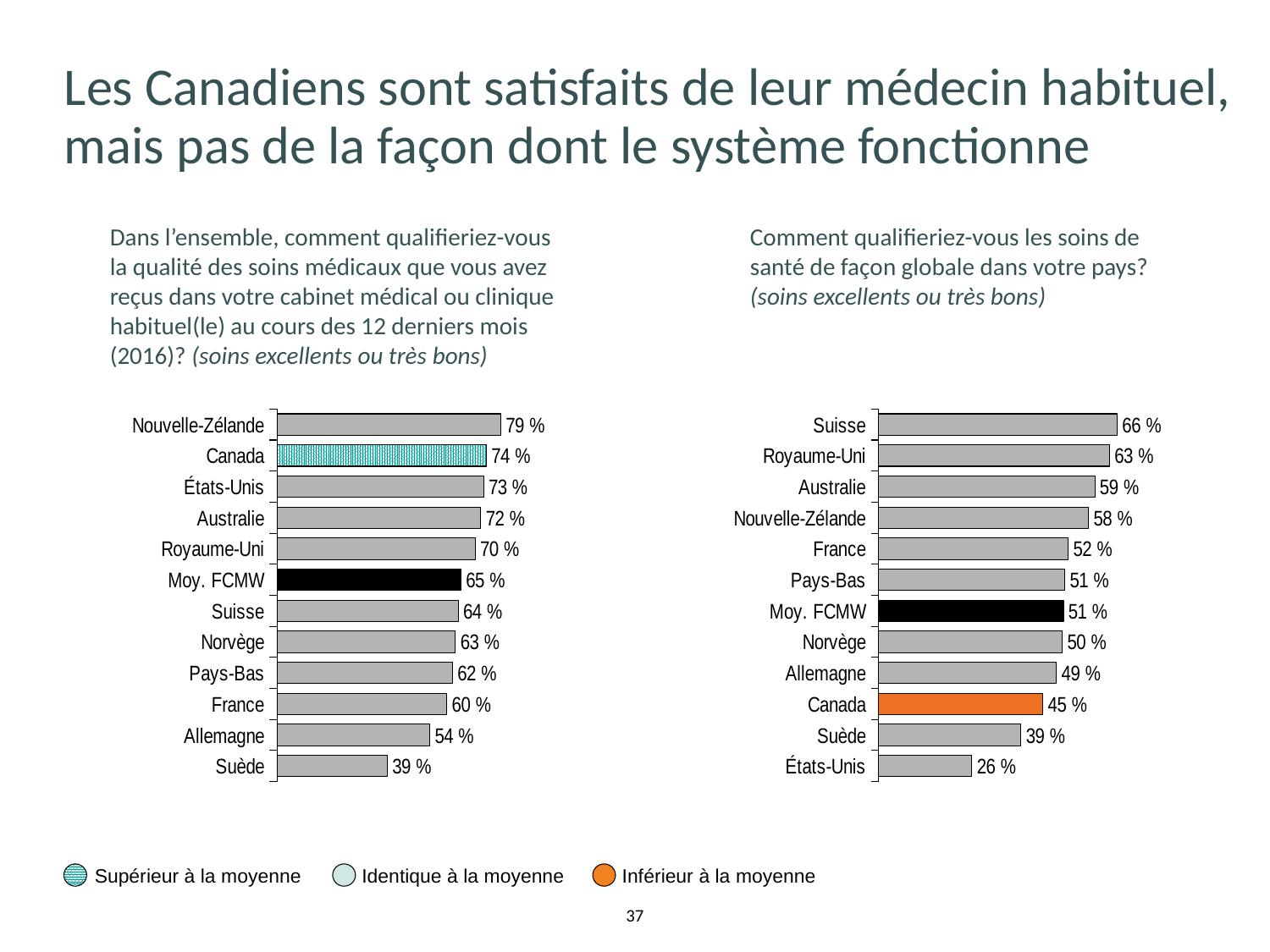
What type of chart is the right chart? Bar chart In the left chart, which country has the highest value? Nouvelle-Zélande In the right chart, which is larger, the value for Royaume-Uni or the value for France? Royaume-Uni In the right chart, which country has the lowest value? États-Unis In the left chart, what is the difference between Nouvelle-Zélande and Suède? 40 % In the left chart, how many bars are shown? 12 In the right chart, what is the difference between Suisse and Canada? 21 % In the left chart, what is the value for Canada? 74 % In the right chart, what colour is the bar for Canada? Orange In the right chart, what is the value for Canada? 45 % In the right chart, what is the value for États-Unis? 26 % In the left chart, what is the value for Moy. FCMW? 65 %